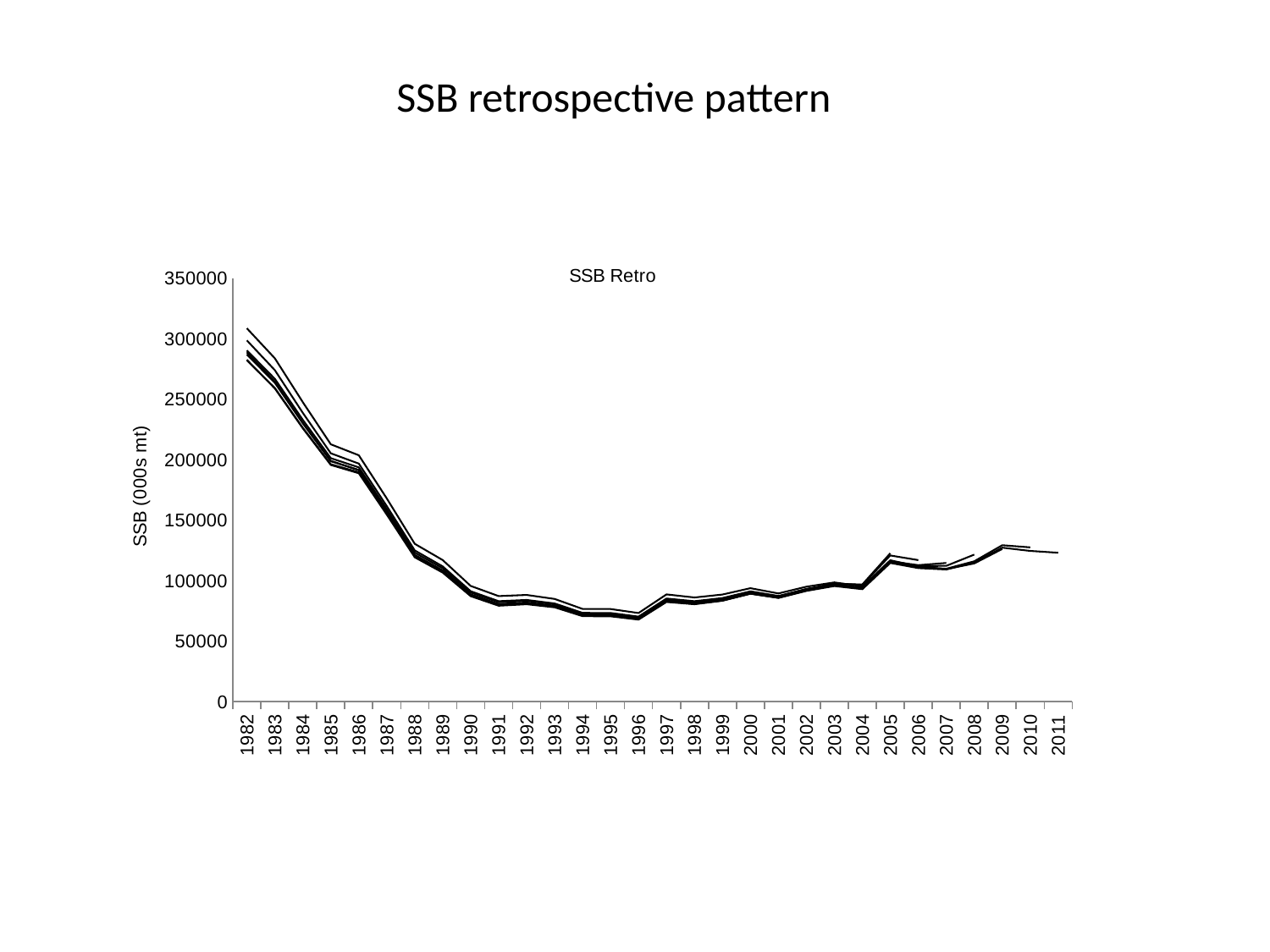
Which year has the highest SSB value in the chart? 1982 Is the SSB value for 1982 greater or less than 250000? greater What kind of chart is shown on the slide? line chart Which year has the larger SSB value, 1988 or 1990? 1988 What is the title printed inside the chart area? SSB Retro How many years are shown along the x axis of the chart? 30 Do the SSB values rise or fall from 1982 to 1996? fall Is the SSB value for 2009 greater or less than 100000? greater What is the label on the vertical axis of the chart? SSB (000s mt) Is the SSB value for 1986 greater or less than 150000? greater Which year has the larger SSB value, 1982 or 2011? 1982